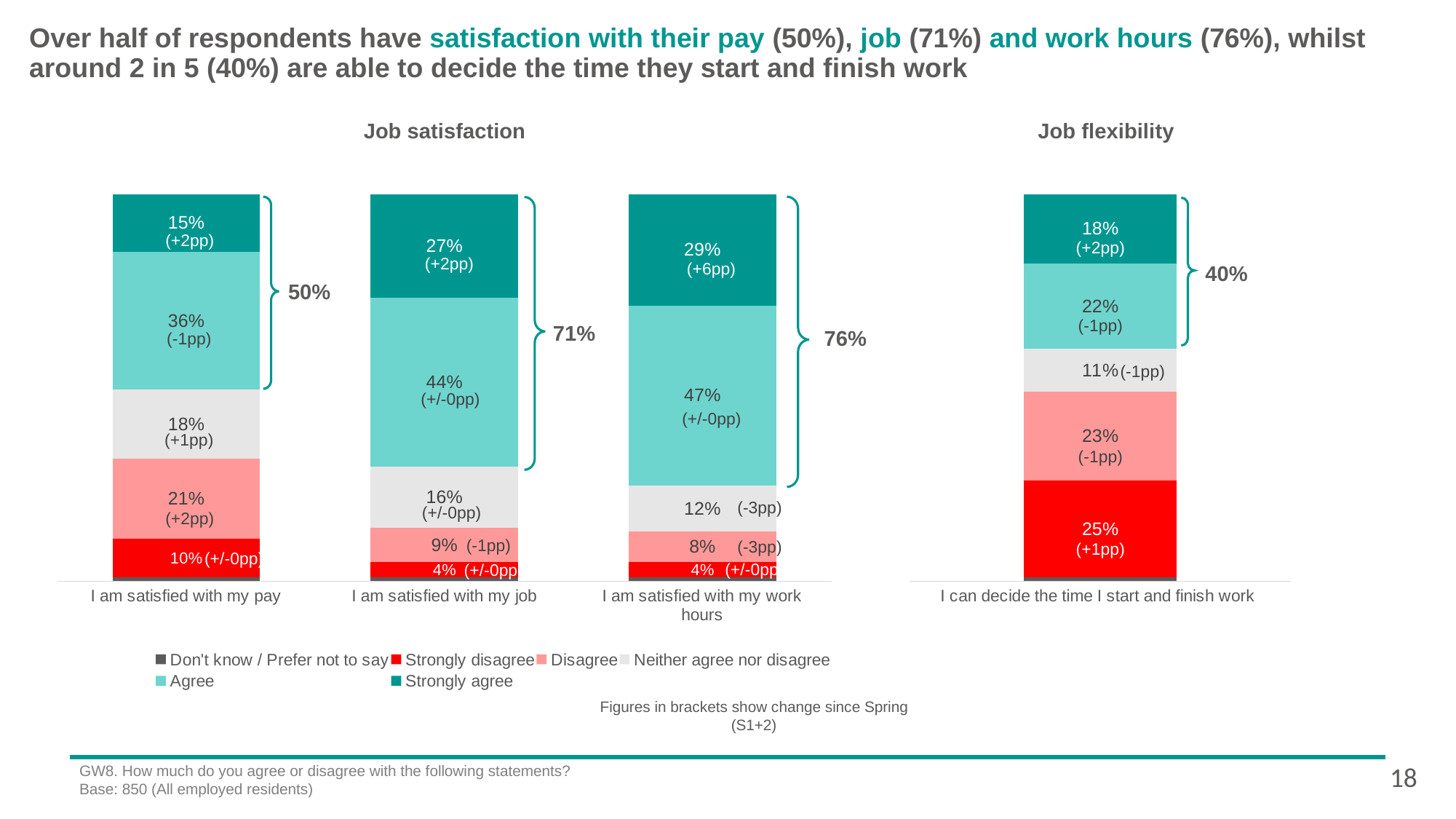
In the Job satisfaction chart, which statement has the highest 'Strongly agree' percentage? I am satisfied with my work hours How many statements (bars) are shown in the Job satisfaction chart? 3 In the Job satisfaction chart, which is larger: the 'Disagree' percentage for 'I am satisfied with my pay' or for 'I am satisfied with my job'? I am satisfied with my pay In the Job flexibility chart, what percentage strongly disagree with 'I can decide the time I start and finish work'? 25% In the Job satisfaction chart, what percentage strongly agree with 'I am satisfied with my work hours'? 29% How many series does the legend list? 6 In the Job satisfaction chart, what change since Spring is shown in brackets for the 'Strongly agree' segment of 'I am satisfied with my work hours'? +6pp In the Job satisfaction chart, what is the difference between the 'Agree' percentages for 'I am satisfied with my work hours' and 'I am satisfied with my pay'? 11 percentage points In the Job satisfaction chart, what is the combined agree/strongly agree figure shown for 'I am satisfied with my job'? 71% In the Job satisfaction chart, what percentage agree with 'I am satisfied with my pay'? 36% In the Job satisfaction chart, which statement has the lowest 'Agree' percentage? I am satisfied with my pay What kind of chart is the Job flexibility chart? Stacked bar chart